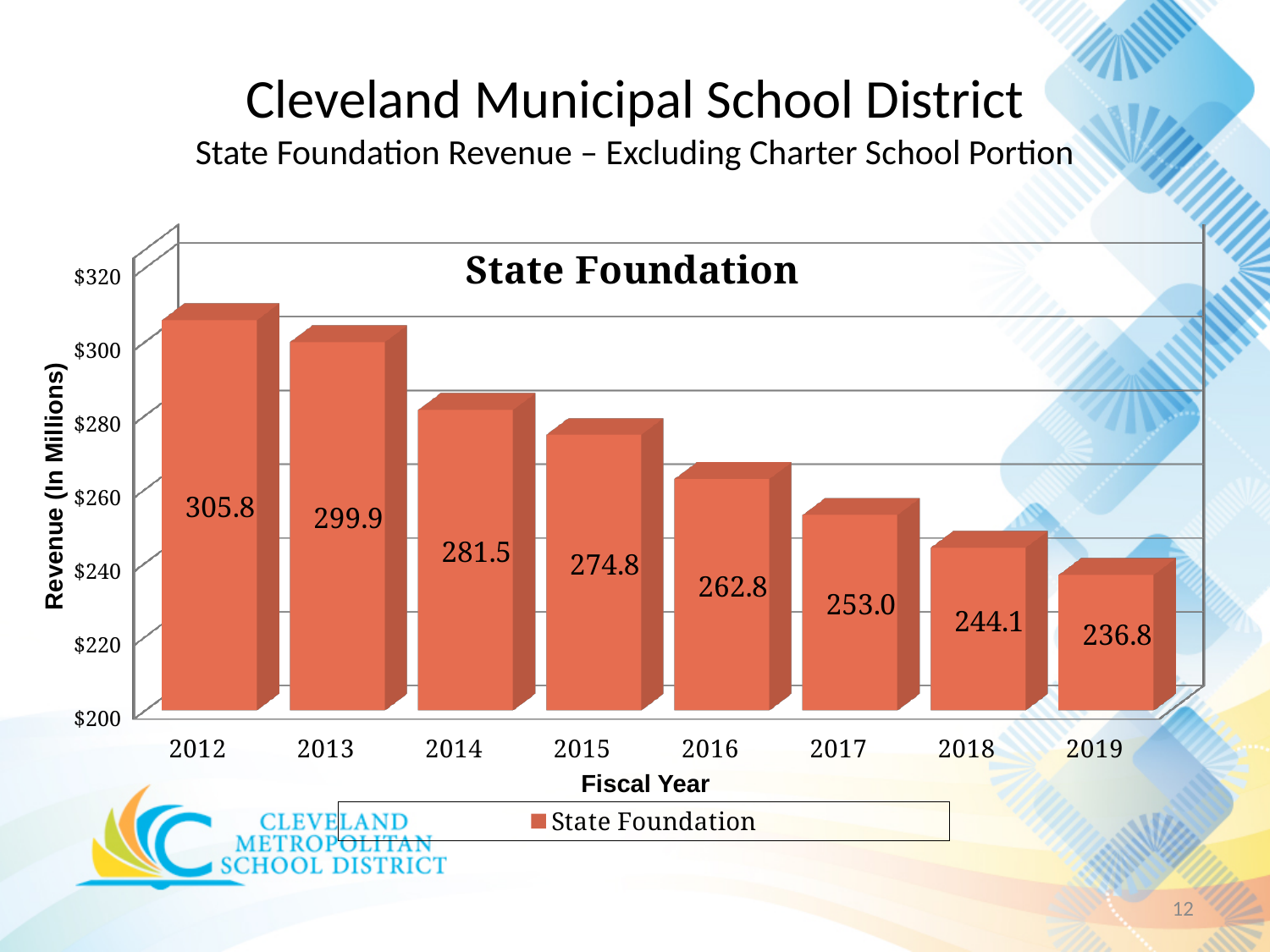
Do the State Foundation revenue values rise or fall from 2012 to 2019? fall What is the State Foundation revenue for fiscal year 2012? 305.8 What is the State Foundation revenue for fiscal year 2016? 262.8 What is the difference between the State Foundation revenue in 2014 and in 2015? 6.7 Which fiscal year has the lowest State Foundation revenue? 2019 What is the State Foundation revenue for fiscal year 2019? 236.8 What kind of chart is shown on the slide? bar chart Which fiscal year has the highest State Foundation revenue? 2012 Is the State Foundation revenue for 2018 greater or less than $260? less How many fiscal years are shown on the chart? 8 What is the difference between the State Foundation revenue in 2012 and in 2019? 69.0 Which is larger, the State Foundation revenue in 2013 or in 2017? 2013